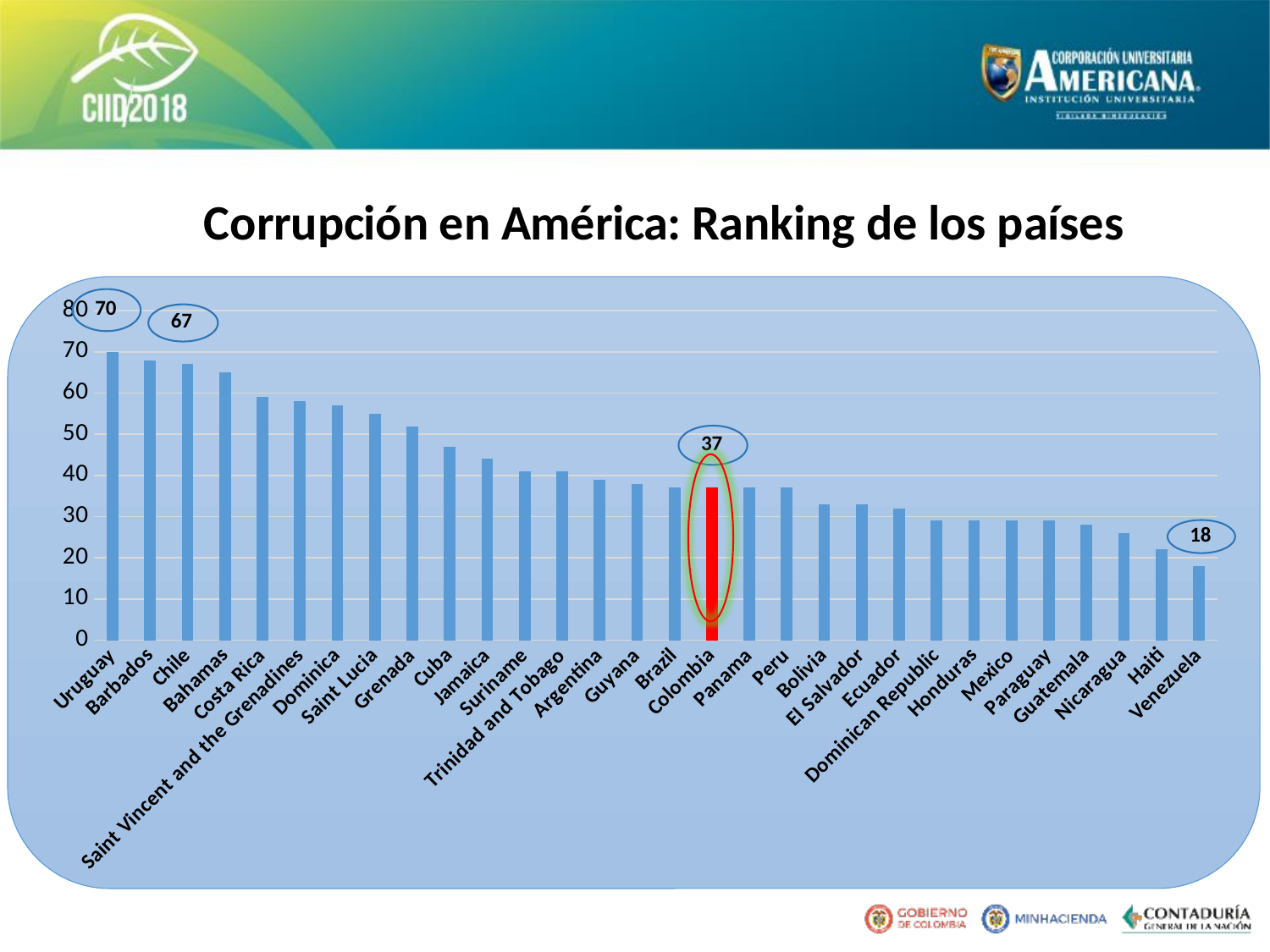
Is the value for Haiti greater or less than 30? less What is the value for Venezuela? 18 What is the value for Colombia? 37 What is the value for Uruguay? 70 What is the difference between the values for Colombia and Venezuela? 19 What colour is the bar for Colombia? Red Is the value for Costa Rica greater or less than 50? greater How many countries are shown in the chart? 30 Which has a larger value, Chile or Peru? Chile Which country has the highest value? Uruguay Which country has the lowest value? Venezuela What is the difference between the values for Uruguay and Venezuela? 52